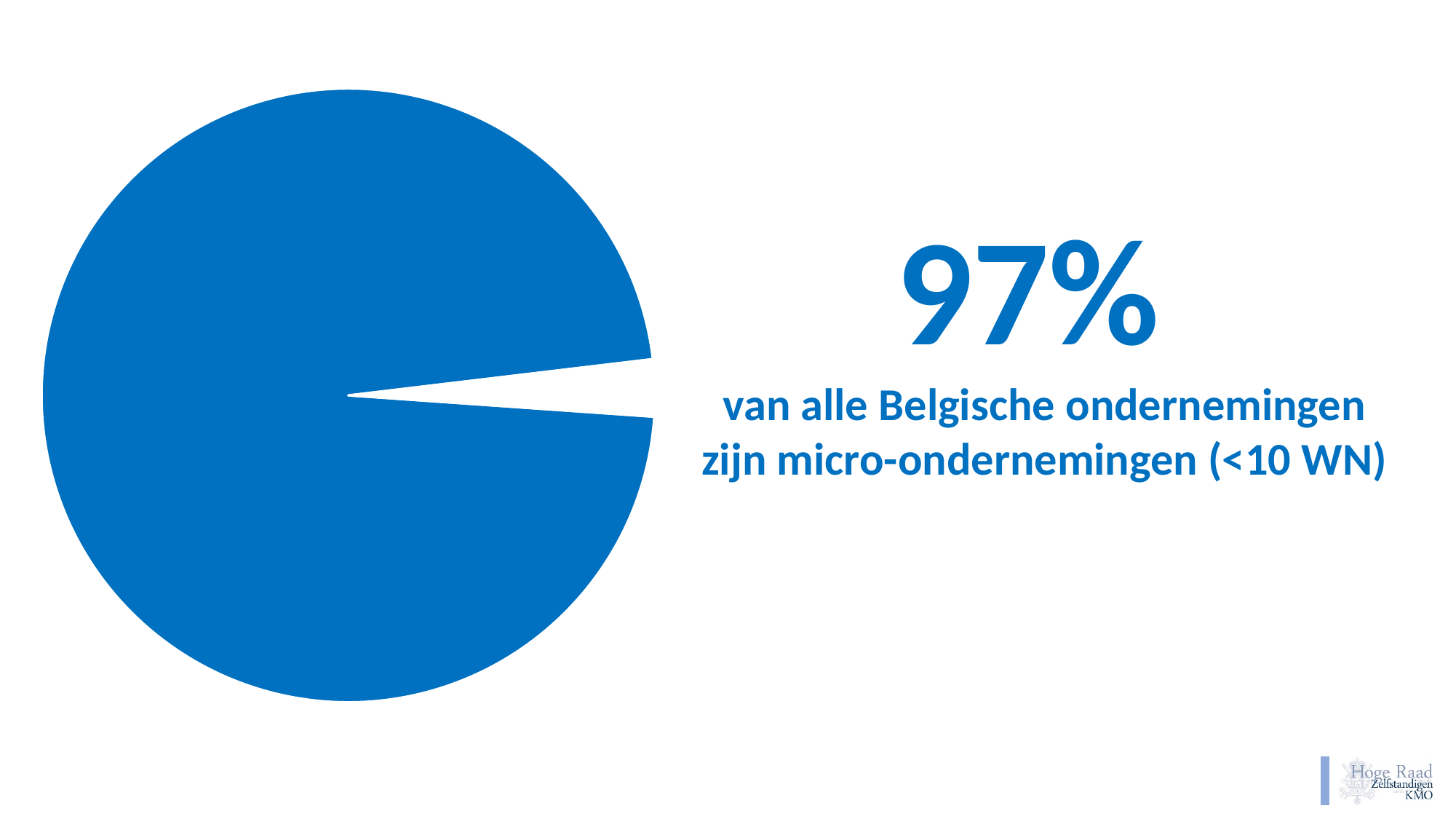
What colour is the large slice of the pie chart? blue According to the slide text, how are micro-enterprises defined? <10 WN What share of the pie is left for the small white slice? 3% Which slice of the pie is larger, the blue one or the white one? the blue one Is the share of the blue slice greater or less than 50%? greater What share of the pie does the large blue slice represent? 97% What percentage of all Belgian enterprises are micro-enterprises according to the slide? 97% How many slices does the pie chart have? 2 What kind of chart is shown on the slide? pie chart